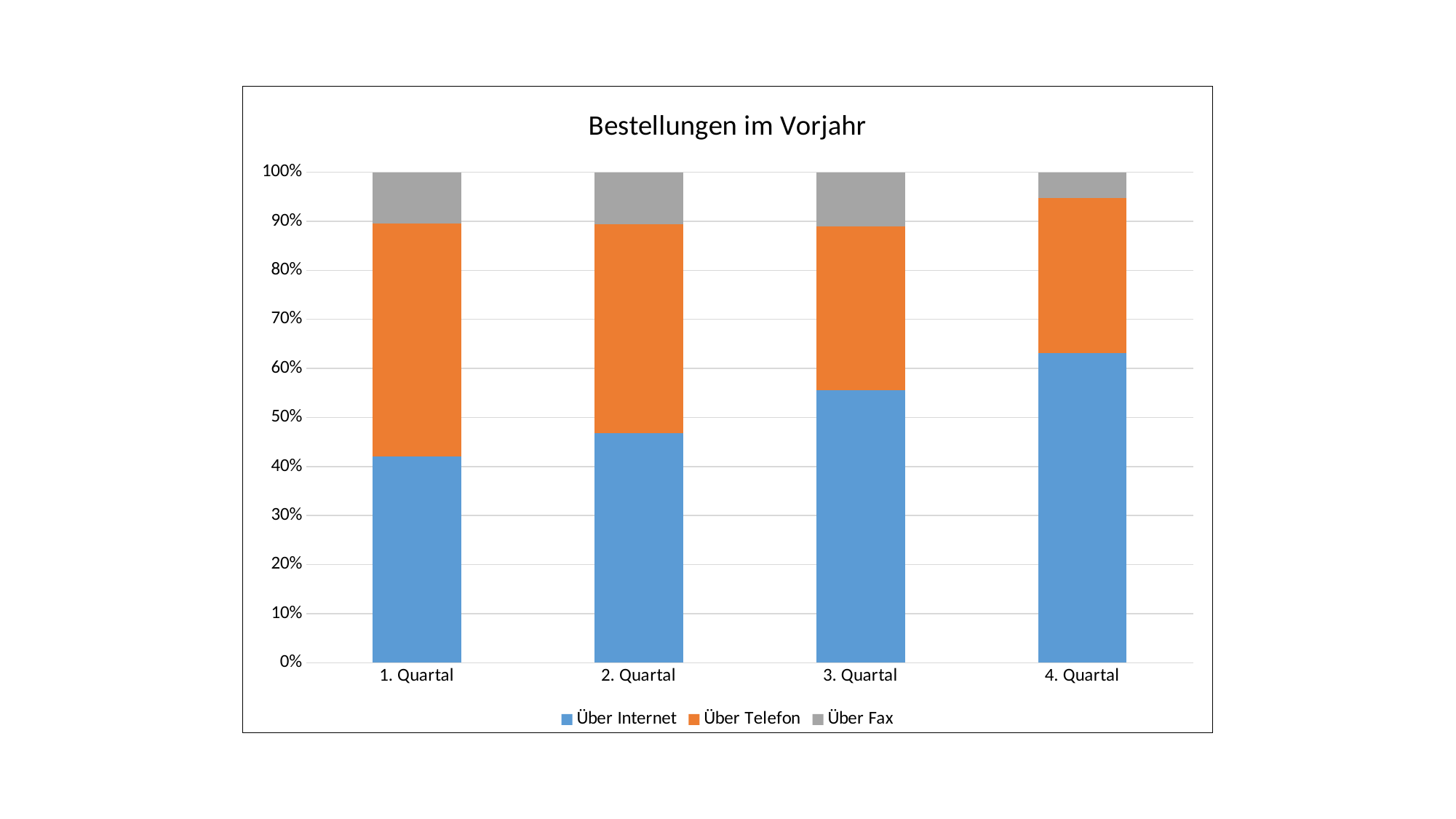
What is the title of the chart? Bestellungen im Vorjahr How many quarters are shown on the x axis? 4 Which series is shown in blue? Über Internet What kind of chart is shown on the slide? stacked bar chart In which quarter is the Über Internet share the largest? 4. Quartal Does the Über Internet share rise or fall from 1. Quartal to 4. Quartal? rise Is the share for Über Internet in 3. Quartal greater or less than 50%? greater Which is larger: the Über Telefon share in 1. Quartal or in 4. Quartal? 1. Quartal Is the share for Über Internet in 1. Quartal greater or less than 50%? less How many series does the legend list? 3 Is the share for Über Internet in 4. Quartal greater or less than 60%? greater In which quarter is the Über Fax share the smallest? 4. Quartal